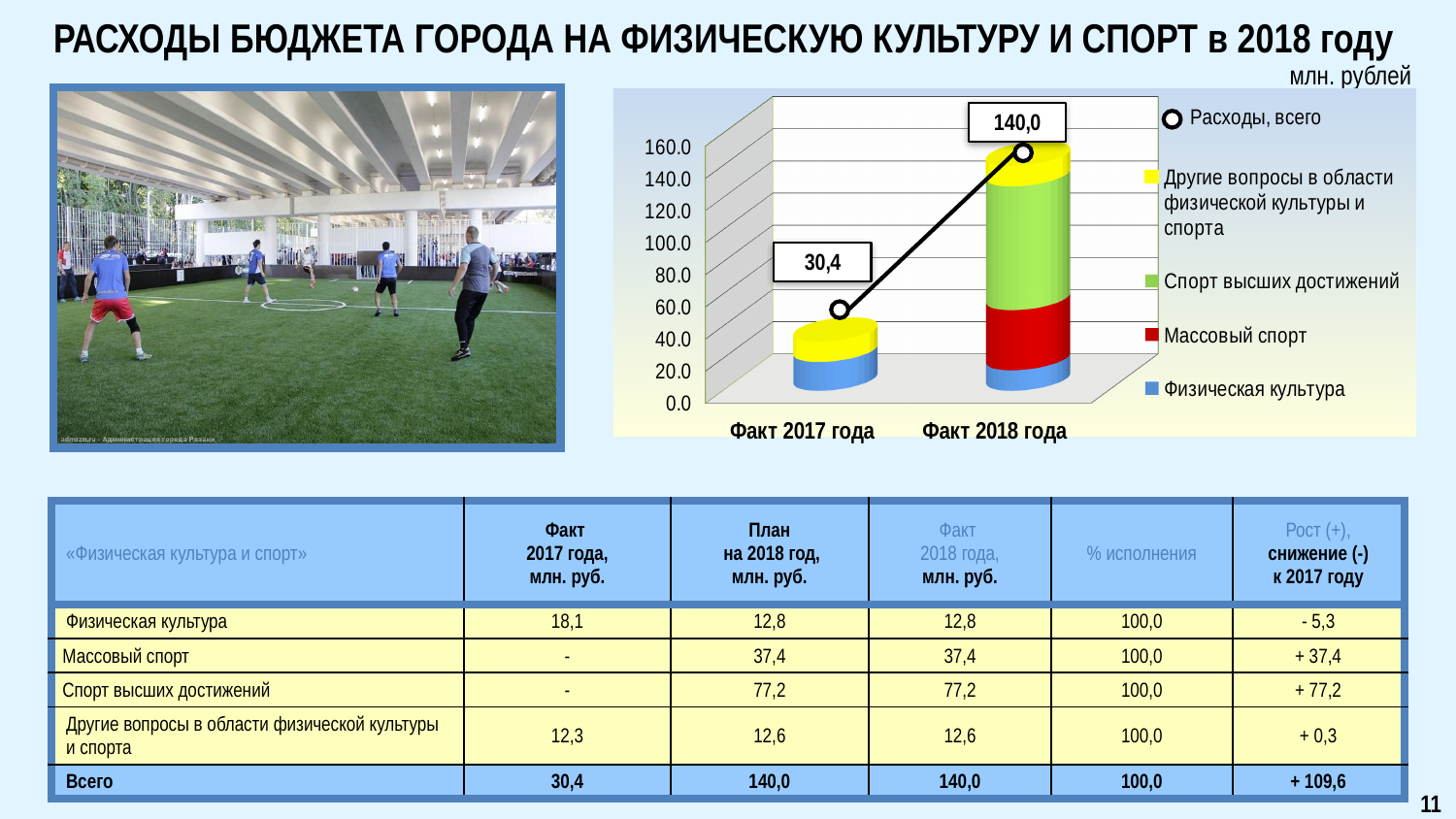
What kind of chart is shown on the slide? Stacked bar chart with a line Is the total for Факт 2018 года greater or less than 120.0? greater Which category has the higher total expenditure, Факт 2017 года or Факт 2018 года? Факт 2018 года Which category has the lower total expenditure? Факт 2017 года What is the value of Расходы, всего for Факт 2017 года? 30,4 Do total expenditures rise or fall from Факт 2017 года to Факт 2018 года? rise How many categories are shown on the x axis of the chart? 2 Is the total for Факт 2017 года greater or less than 40.0? less What is the value of Расходы, всего for Факт 2018 года? 140,0 How many entries does the chart legend list? 5 What colour represents Массовый спорт in the chart? Red By how much does the total for Факт 2018 года exceed the total for Факт 2017 года? 109,6